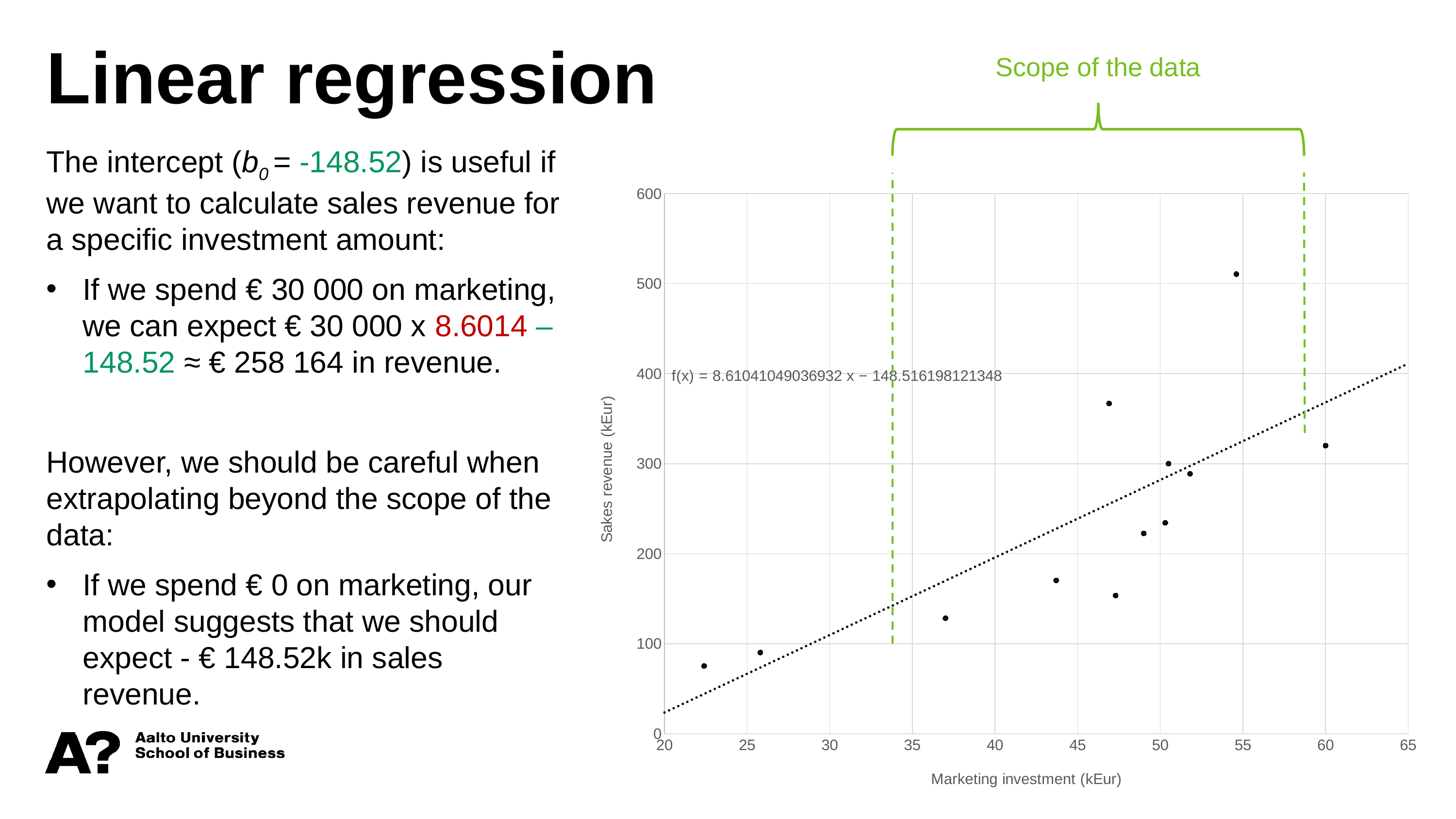
What is the label of the x axis of the chart? Marketing investment (kEur) What is the highest value shown on the y axis of the chart? 600 Is the sales revenue of the data point at a marketing investment of about 60 kEur greater or less than 300? greater Do sales revenue values generally rise or fall as marketing investment increases along the x axis? rise Is the sales revenue of the data point with the highest marketing investment (around 60 kEur) greater or less than 400? less How many data points are plotted in the scatter chart? 12 Is the sales revenue of the lowest data point greater or less than 100? less What kind of chart is shown on the slide? scatter chart What trendline equation is printed on the chart? f(x) = 8.61041049036932 x − 148.516198121348